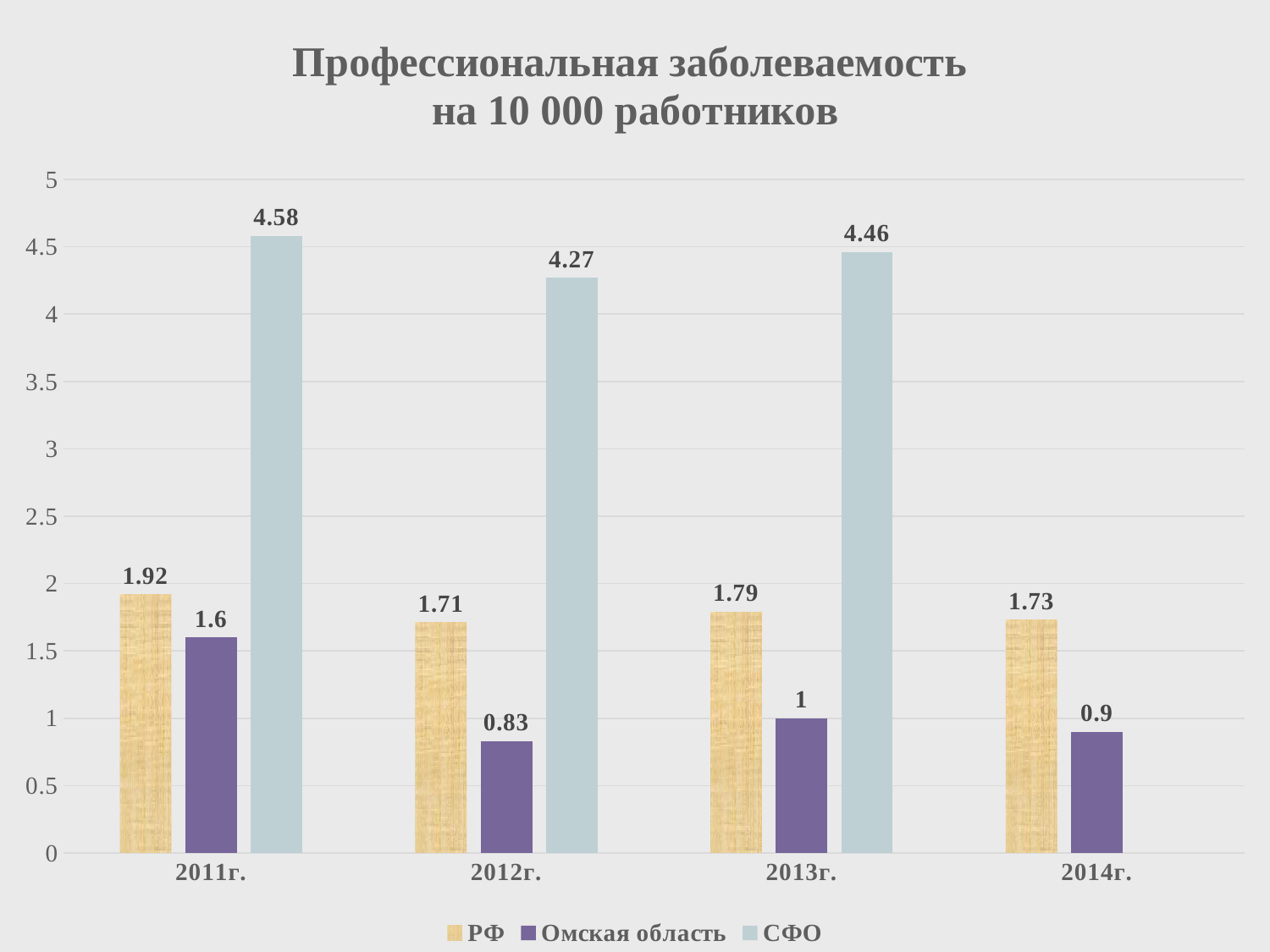
What kind of chart is shown on the slide? Bar chart What is the value for Омская область in 2012г.? 0.83 What is the difference between the СФО value and the РФ value in 2011г.? 2.66 What is the value for Омская область in 2014г.? 0.9 How many years are shown on the x axis? 4 In which year is the value for Омская область lowest? 2012г. In which year is the value for СФО highest? 2011г. How many series does the legend list? 3 Which is larger in 2013г., the value for РФ or the value for Омская область? РФ What is the title of the chart? Профессиональная заболеваемость на 10 000 работников What is the value for СФО in 2013г.? 4.46 What is the value for РФ in 2011г.? 1.92